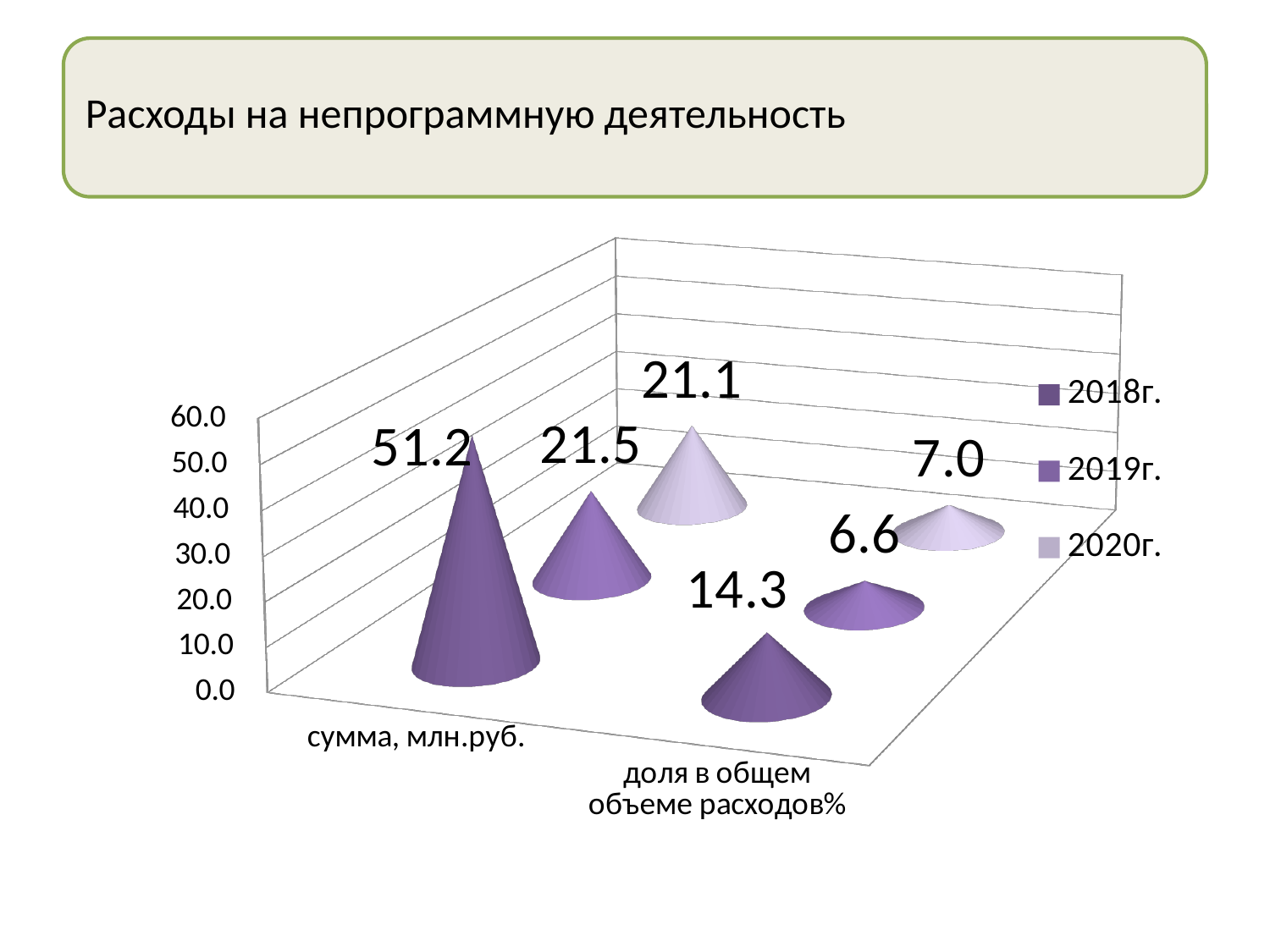
What is the difference between the 2018г. and 2019г. values in the category 'сумма, млн.руб.'? 29.7 What is the value for 2020г. in the category 'сумма, млн.руб.'? 21.1 What is the title of the slide above the chart? Расходы на непрограммную деятельность What is the value for 2020г. in the category 'доля в общем объеме расходов%'? 7.0 What is the value for 2018г. in the category 'доля в общем объеме расходов%'? 14.3 What is the value for 2019г. in the category 'сумма, млн.руб.'? 21.5 Which year has the lowest value in the category 'доля в общем объеме расходов%'? 2019г. What is the value for 2018г. in the category 'сумма, млн.руб.'? 51.2 Which is larger in the category 'доля в общем объеме расходов%': the value for 2019г. or for 2020г.? 2020г. What is the value for 2019г. in the category 'доля в общем объеме расходов%'? 6.6 How many series does the legend list? 3 Which year has the highest value in the category 'сумма, млн.руб.'? 2018г.